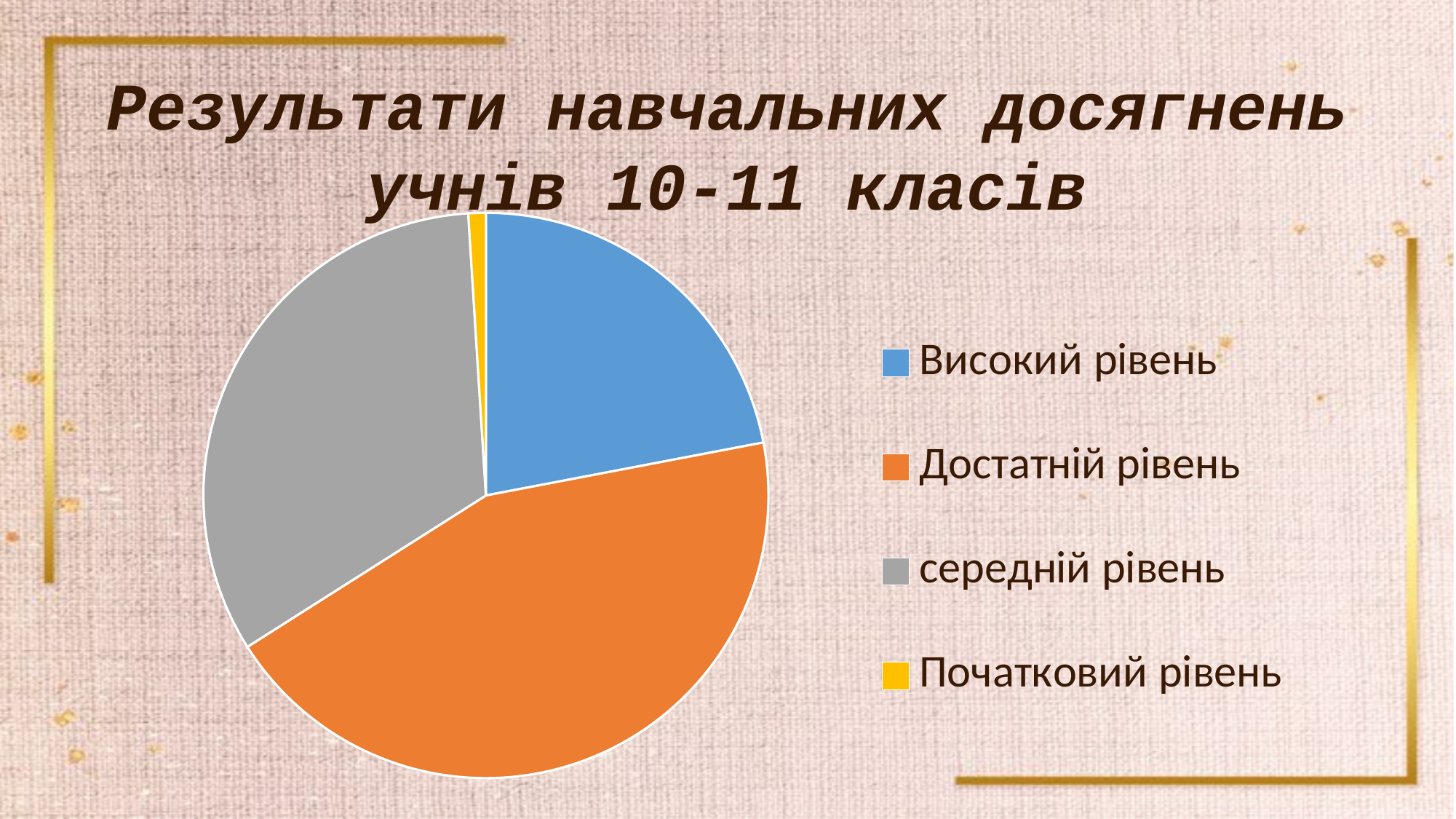
How many entries does the legend list? 4 What colour is the slice for Достатній рівень? orange Which slice is larger: середній рівень or Високий рівень? середній рівень Which slice is larger: Достатній рівень or середній рівень? Достатній рівень What is the title of the slide containing the chart? Результати навчальних досягнень учнів 10-11 класів Which category has the smallest slice of the pie? Початковий рівень How many slices does the pie chart have? 4 What kind of chart is shown on the slide? pie chart Which slice is larger: Високий рівень or Початковий рівень? Високий рівень Which category has the largest slice of the pie? Достатній рівень